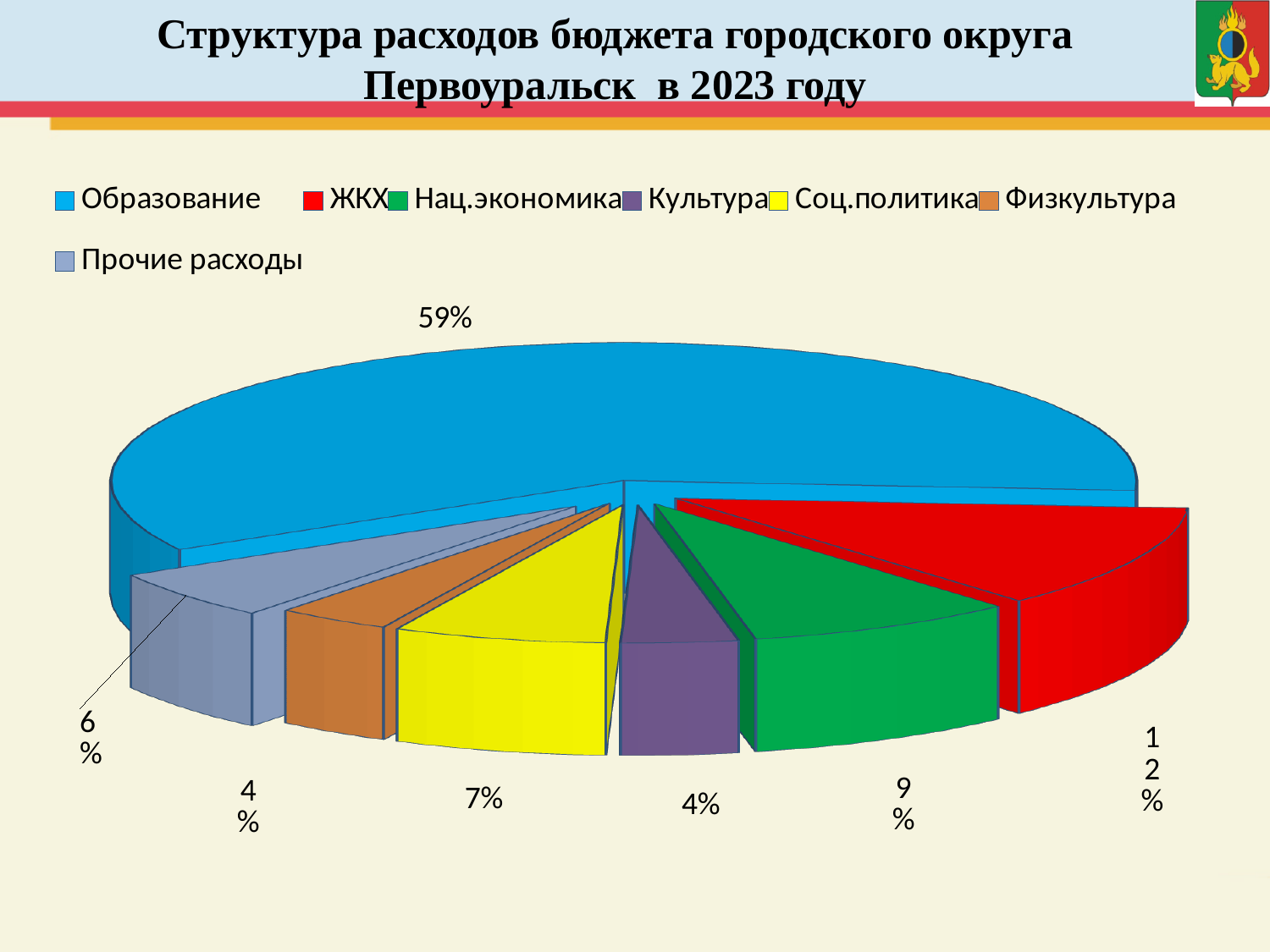
What is the title of the slide? Структура расходов бюджета городского округа Первоуральск в 2023 году Which colour represents Культура in the chart? purple What share of the budget expenditure goes to Нац.экономика? 9% How many categories does the legend list? 7 What share of the budget expenditure goes to Образование? 59% What kind of chart is shown on the slide? pie chart What share of the budget expenditure goes to Соц.политика? 7% Which category has the largest share of the budget expenditure? Образование Which has a larger share, Нац.экономика or Соц.политика? Нац.экономика What is the difference in percentage points between the shares of Образование and ЖКХ? 47